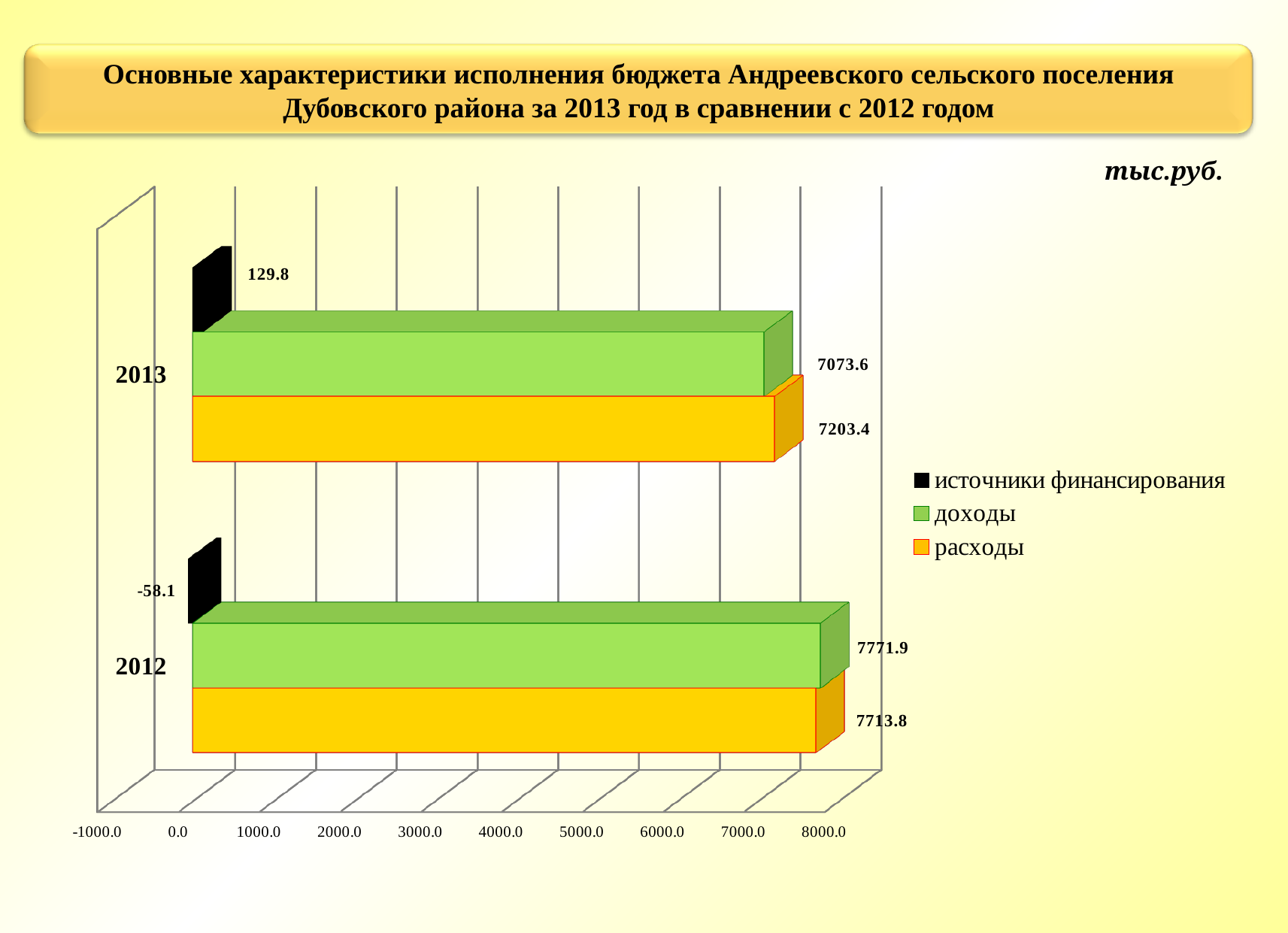
Is the value of расходы for 2013 greater or less than 7000.0? greater Which year has the higher value for доходы, 2012 or 2013? 2012 What is the difference between доходы in 2012 and доходы in 2013? 698.3 What is the value of расходы for 2012? 7713.8 What is the value of источники финансирования for 2012? -58.1 What is the value of источники финансирования for 2013? 129.8 How many series does the legend list? 3 What is the difference between расходы and доходы for 2013? 129.8 What type of chart is shown on the slide? bar chart What is the value of доходы for 2013? 7073.6 How many year categories are shown on the chart? 2 What unit of measurement is indicated above the chart? тыс.руб.